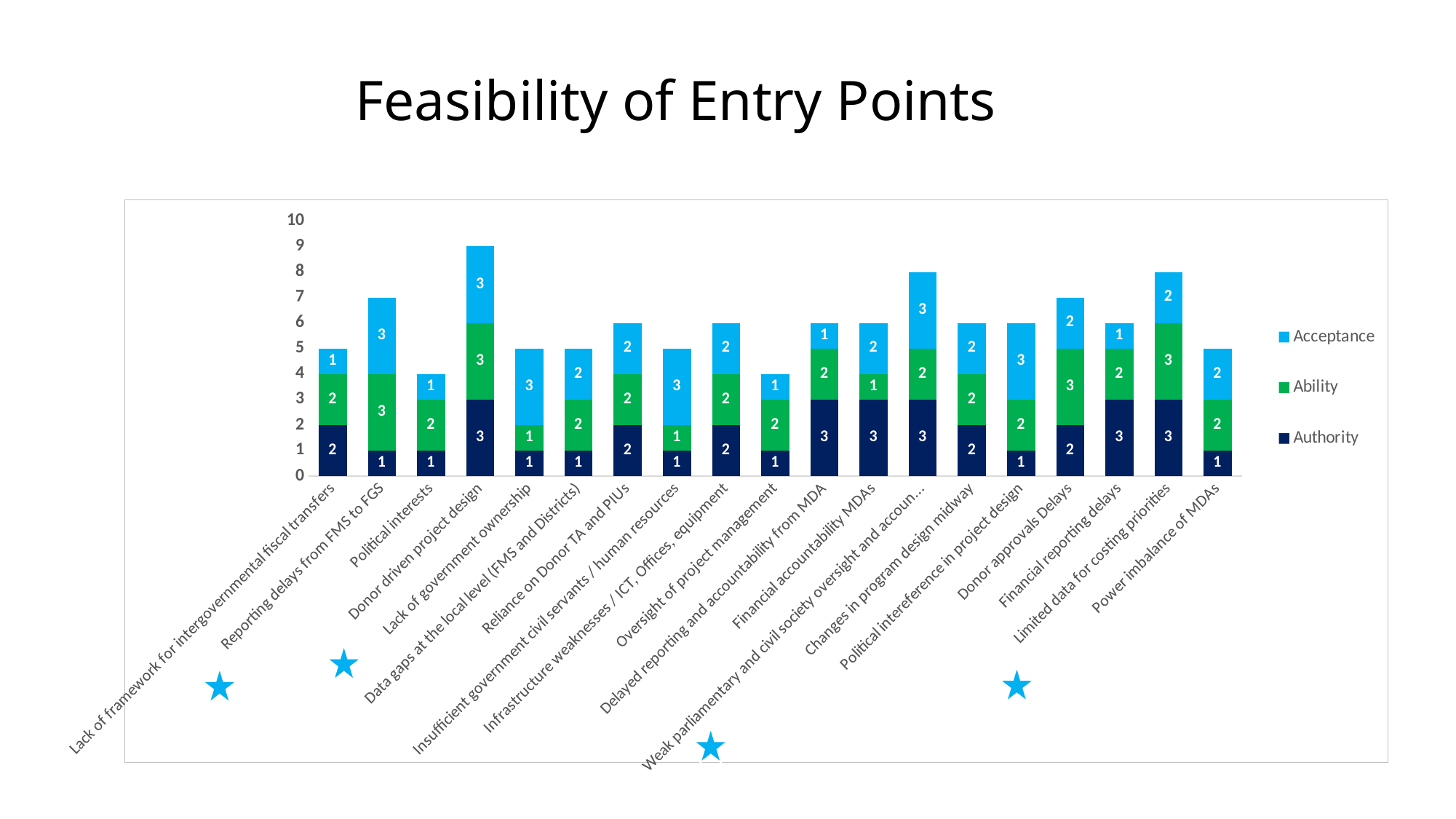
What is the title of the chart? Feasibility of Entry Points What is the Authority value for Donor driven project design? 3 Which category has the highest total stacked bar? Donor driven project design What is the Acceptance value for Lack of government ownership? 3 What is the total of the stacked bar for Donor driven project design? 9 Which is larger: the total bar for Donor approvals Delays or the total bar for Power imbalance of MDAs? Donor approvals Delays How many series does the legend list? 3 How many categories are plotted along the x axis? 19 What is the difference between the Acceptance value for Reporting delays from FMS to FGS and the Acceptance value for Political interests? 2 What type of chart is shown on the slide? stacked bar chart What is the Ability value for Financial accountability MDAs? 1 What is the total of the stacked bar for Limited data for costing priorities? 8